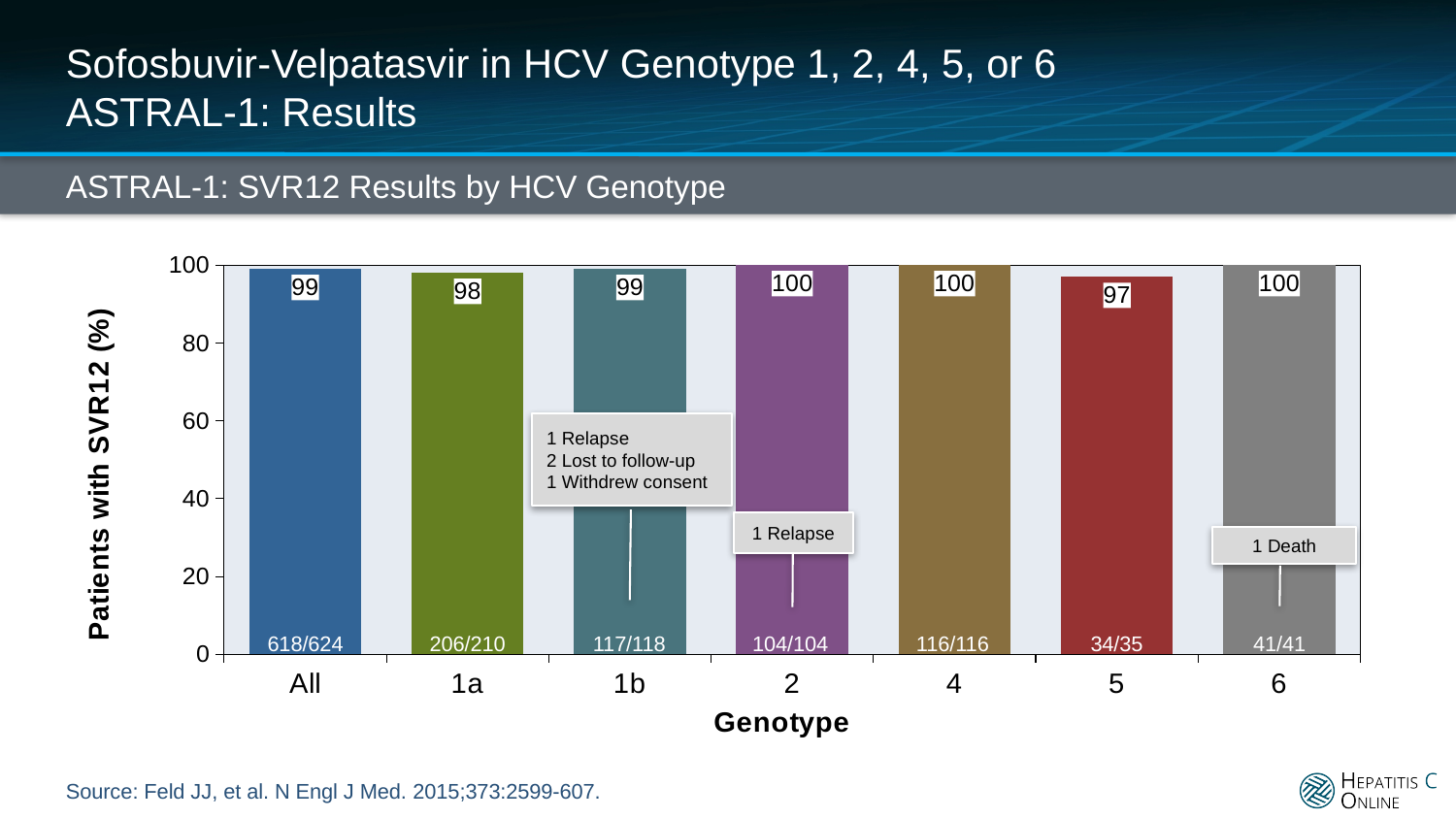
What is the SVR12 rate for genotype 1a? 98 What is the label on the y axis? Patients with SVR12 (%) How many genotype categories are shown on the x axis? 7 How many genotypes have an SVR12 rate of 100? 3 What is the difference in SVR12 rate between genotype 2 and genotype 5? 3 What fraction of patients is shown at the base of the genotype 1b bar? 117/118 What is the SVR12 rate for genotype 5? 97 Which genotype has the lowest SVR12 rate? 5 What is the SVR12 rate for the All group? 99 Which has a higher SVR12 rate, genotype 1a or genotype 4? Genotype 4 What kind of chart is shown on the slide? Bar chart